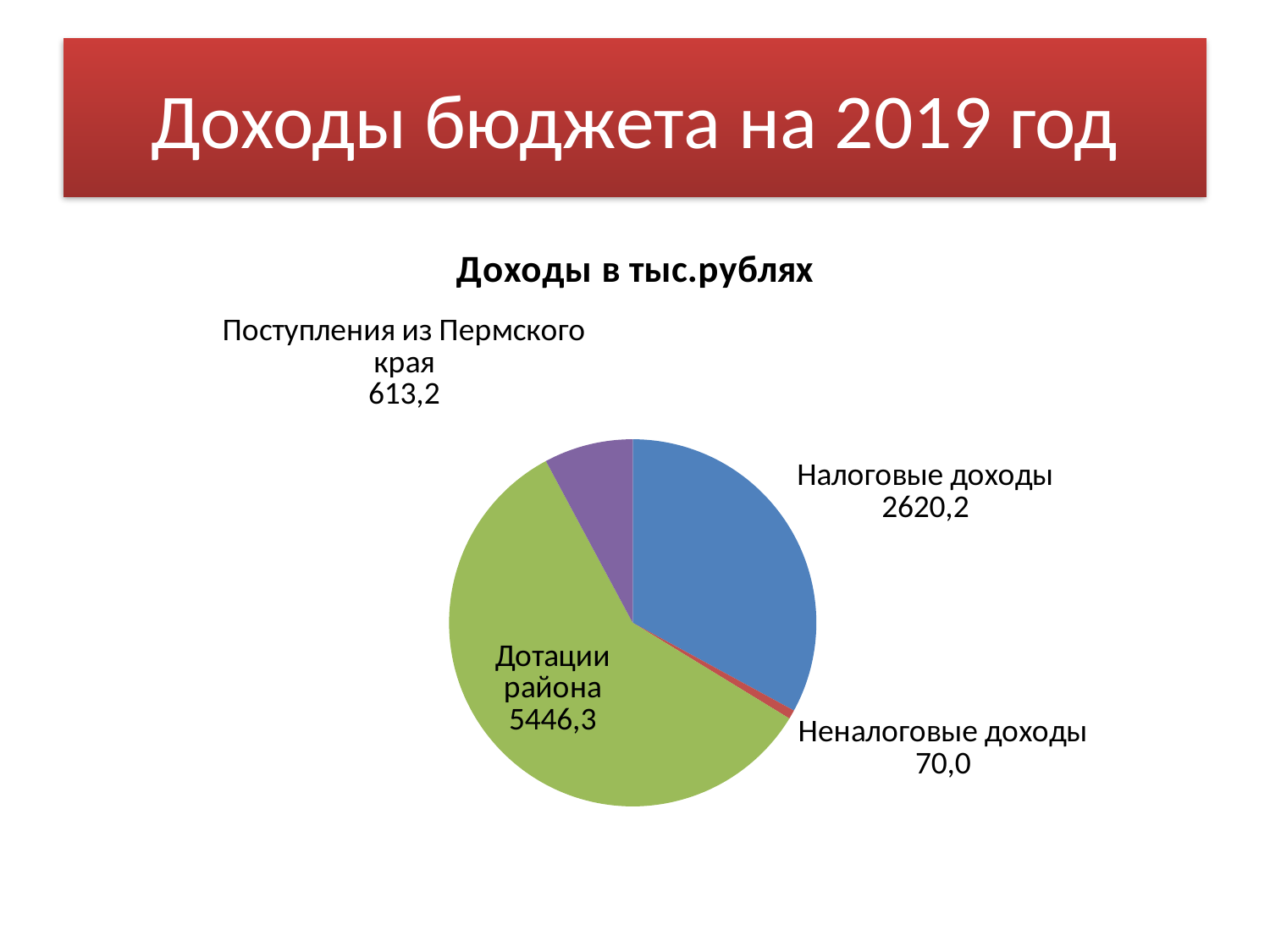
What is the value for Дотации района? 5446,3 Which category has the largest value? Дотации района What is the value for Неналоговые доходы? 70,0 What is the total of all four categories in the pie chart? 8749,7 How many slices does the pie chart have? 4 What is the value for Налоговые доходы? 2620,2 What is the value for Поступления из Пермского края? 613,2 Which is larger, Поступления из Пермского края or Неналоговые доходы? Поступления из Пермского края Which category has the smallest value? Неналоговые доходы What is the difference between Дотации района and Налоговые доходы? 2826,1 What is the title of the chart? Доходы в тыс.рублях What type of chart is shown on the slide? Pie chart